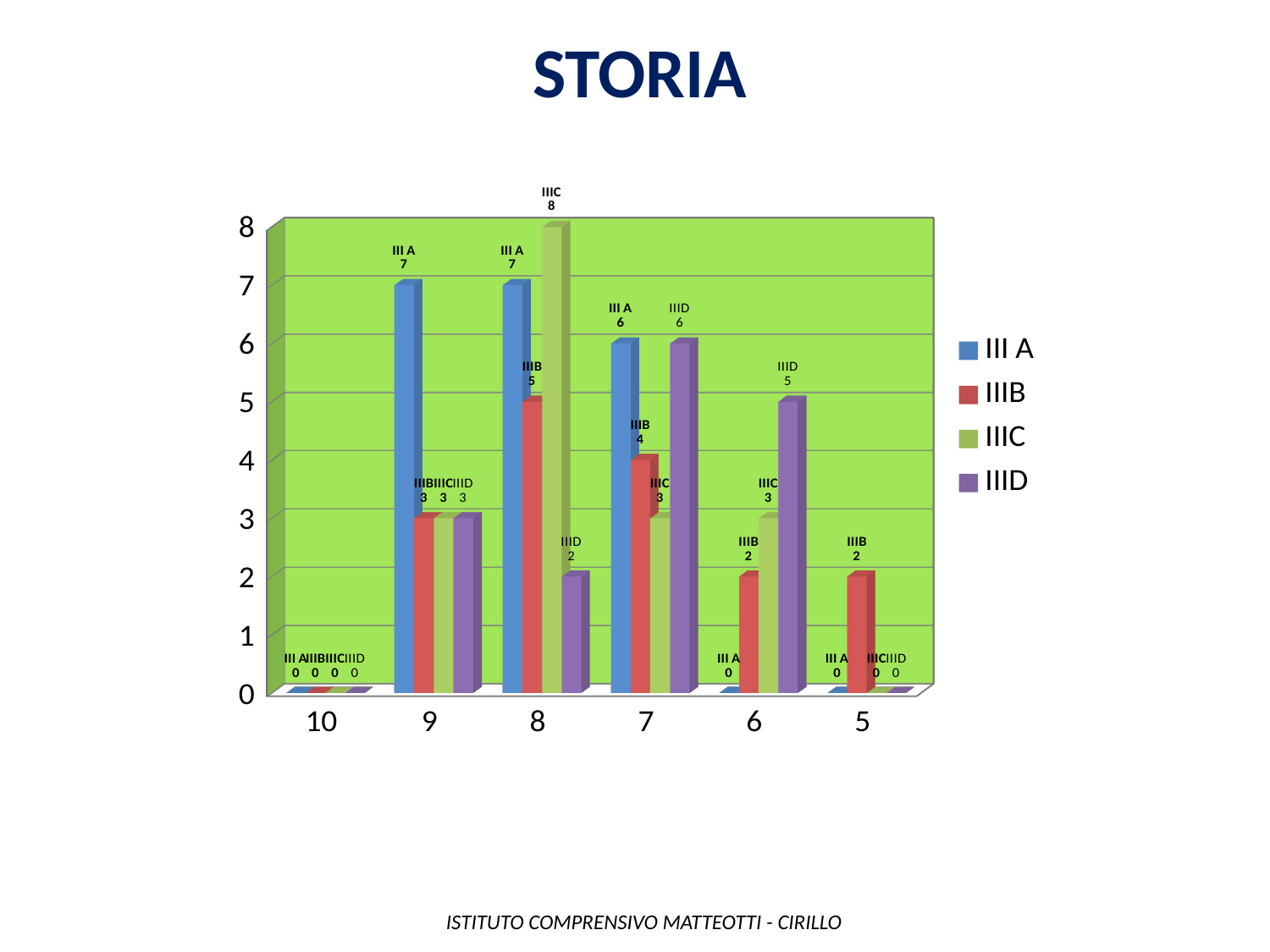
Which is larger at grade 7: the value for III A or the value for IIIC? III A Which series has the highest value at grade 8? IIIC What kind of chart is shown on the slide? bar chart What is the value for IIIB at grade 7? 4 What is the value for IIIC at grade 8? 8 How many grade categories are shown on the x axis? 6 What is the value for III A at grade 9? 7 What is the title of the chart? STORIA Which series has the lowest value at grade 6? III A How many series does the legend list? 4 What is the value for IIID at grade 6? 5 What is the difference between the IIIC value and the IIID value at grade 8? 6